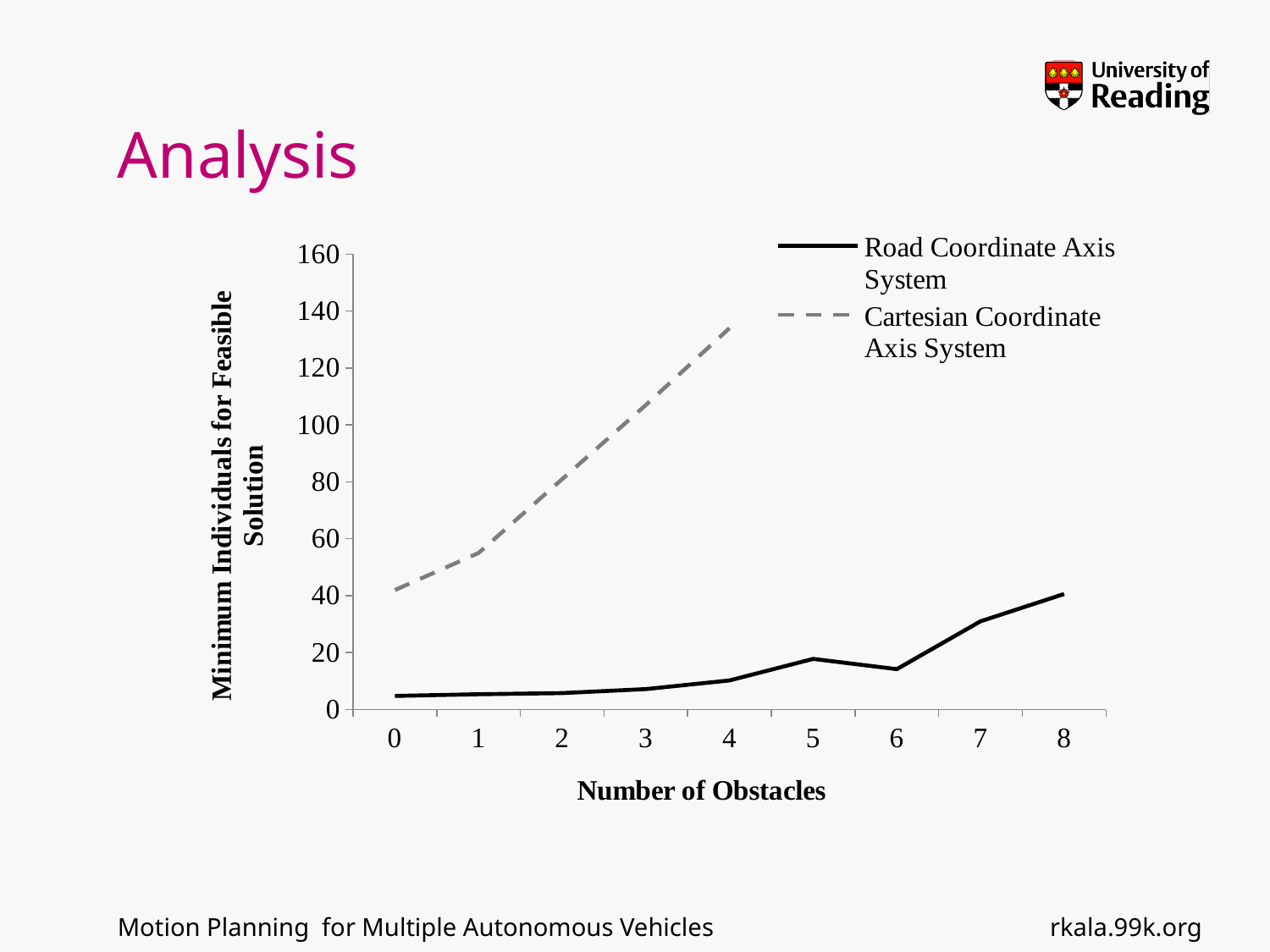
Is the value for the Cartesian Coordinate Axis System at 4 obstacles greater or less than 120? greater How many series does the legend list? 2 Does the Cartesian Coordinate Axis System line rise or fall as the number of obstacles increases? rise At 1 obstacle, which series has the larger value: Road Coordinate Axis System or Cartesian Coordinate Axis System? Cartesian Coordinate Axis System How many values are labelled on the x axis (Number of Obstacles)? 9 What is the title of the y axis? Minimum Individuals for Feasible Solution Is the value for the Road Coordinate Axis System at 0 obstacles greater or less than 20? less For the Road Coordinate Axis System, at which number of obstacles is the value highest? 8 Is the value for the Road Coordinate Axis System at 7 obstacles greater or less than 40? less What kind of chart is shown on the slide? line chart For the Cartesian Coordinate Axis System, at which number of obstacles is the value highest? 4